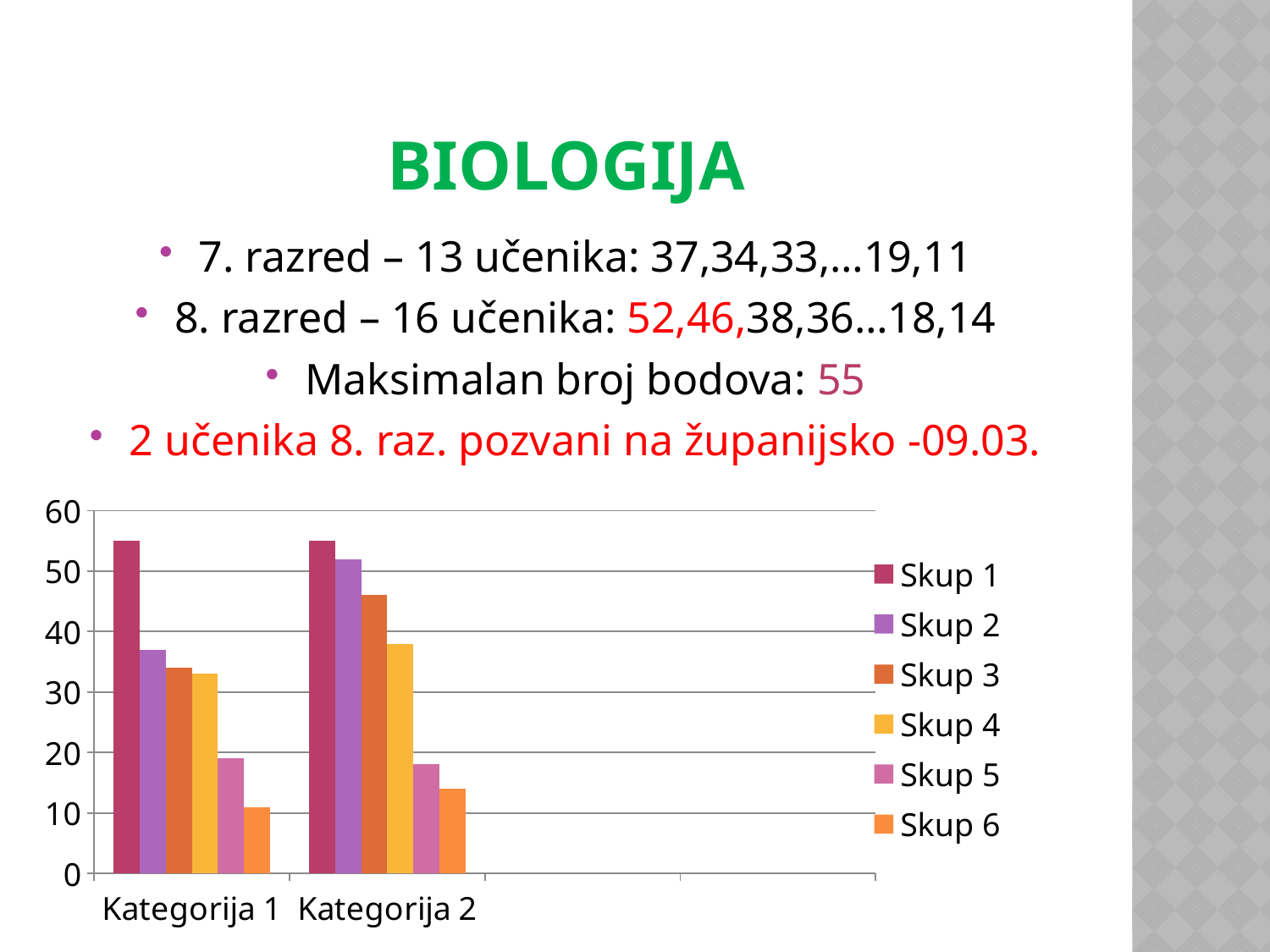
What is the highest value shown on the chart's vertical axis? 60 Which is larger: the Skup 2 bar in Kategorija 1 or the Skup 2 bar in Kategorija 2? Kategorija 2 How many series does the chart legend list? 6 How many categories are shown on the x axis of the chart? 2 Is the value for Skup 3 in Kategorija 2 greater or less than 40? greater In Kategorija 1, which series has the lowest bar? Skup 6 Which is larger: the Skup 4 bar in Kategorija 1 or the Skup 3 bar in Kategorija 2? Skup 3 in Kategorija 2 Is the value for Skup 2 in Kategorija 2 greater or less than 50? greater Is the value for Skup 6 in Kategorija 1 greater or less than 20? less In Kategorija 2, which series has the lowest bar? Skup 6 What kind of chart is shown on the slide? bar chart In Kategorija 1, which series has the highest bar? Skup 1